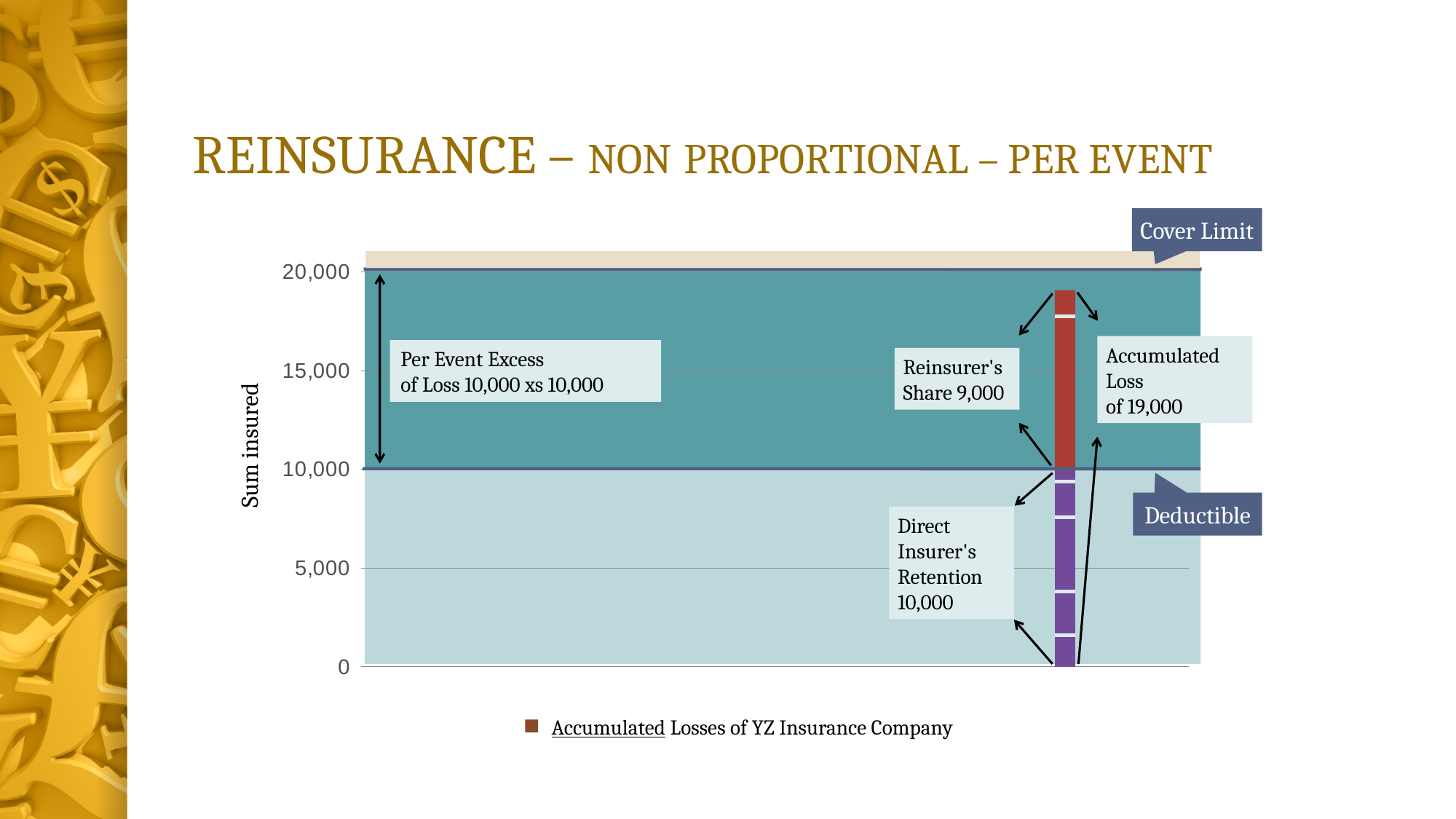
What is the total of the stacked bar (retention plus reinsurer's share)? 19,000 How many series does the chart legend list? 1 At what value on the Sum insured axis is the Cover Limit line drawn? 20,000 Is the accumulated loss greater or less than 15,000? greater What is the accumulated loss of YZ Insurance Company shown on the chart? 19,000 What kind of chart is shown on the slide? Bar chart At what value on the Sum insured axis is the Deductible line drawn? 10,000 What is the reinsurer's share shown on the chart? 9,000 Which is larger, the direct insurer's retention or the reinsurer's share? Direct insurer's retention What is the difference between the direct insurer's retention and the reinsurer's share? 1,000 What is the direct insurer's retention shown on the chart? 10,000 What is the label of the vertical axis? Sum insured